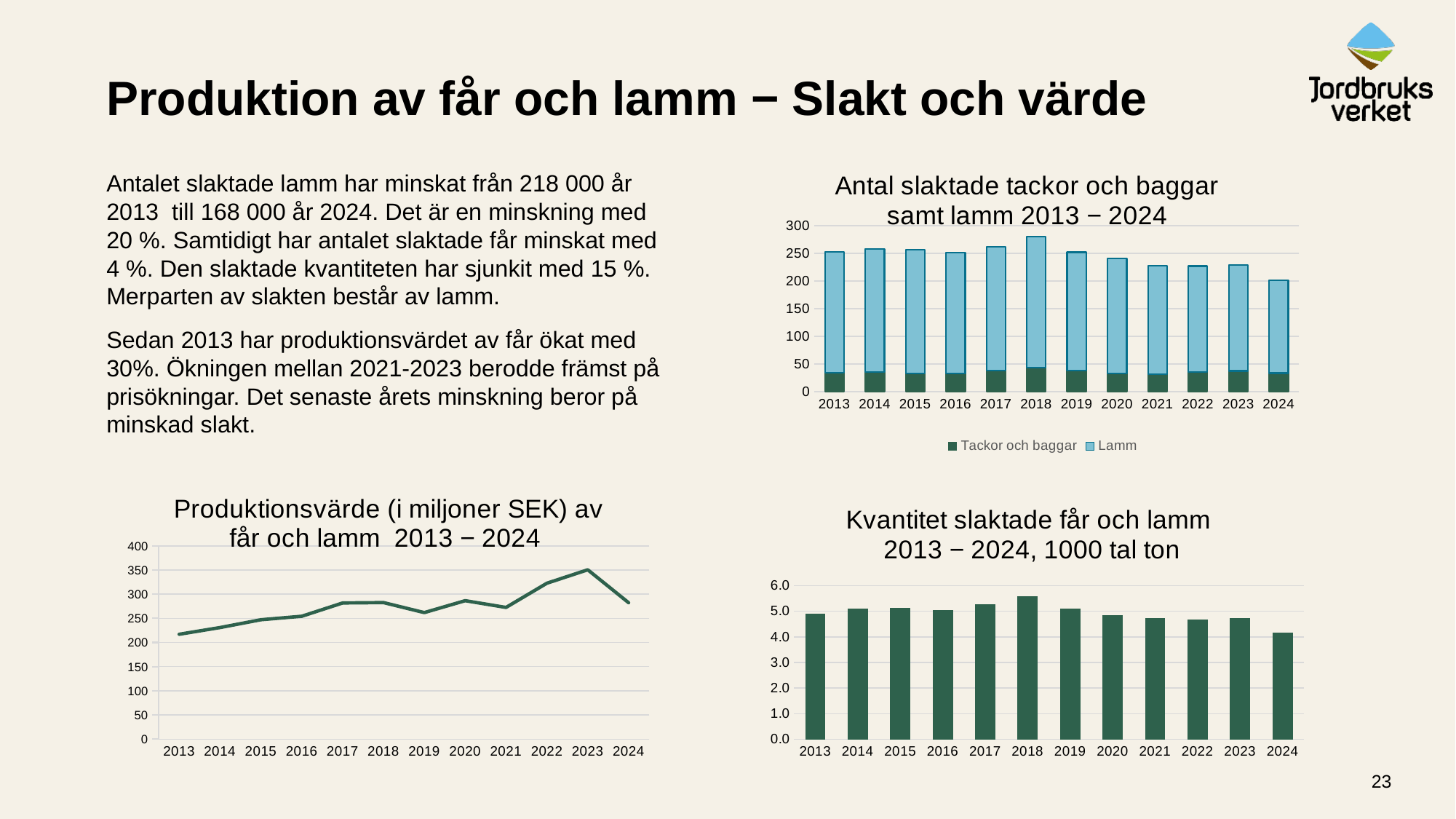
What kind of chart is "Produktionsvärde (i miljoner SEK) av får och lamm 2013 − 2024"? line chart In the chart "Produktionsvärde (i miljoner SEK) av får och lamm 2013 − 2024", which year has the lowest value? 2013 In the chart "Kvantitet slaktade får och lamm 2013 − 2024, 1000 tal ton", is the value for 2024 greater or less than 5.0? less How many years are shown on the x axis of the chart "Kvantitet slaktade får och lamm 2013 − 2024, 1000 tal ton"? 12 In the chart "Antal slaktade tackor och baggar samt lamm 2013 − 2024", is the total for 2024 greater or less than 250? less In the chart "Produktionsvärde (i miljoner SEK) av får och lamm 2013 − 2024", is the value for 2023 greater or less than 300? greater In the chart "Antal slaktade tackor och baggar samt lamm 2013 − 2024", which year has the lowest total bar? 2024 In the chart "Antal slaktade tackor och baggar samt lamm 2013 − 2024", how many series does the legend list? 2 What kind of chart is "Kvantitet slaktade får och lamm 2013 − 2024, 1000 tal ton"? bar chart In the chart "Produktionsvärde (i miljoner SEK) av får och lamm 2013 − 2024", which year has the highest value? 2023 In the chart "Antal slaktade tackor och baggar samt lamm 2013 − 2024", which year has the highest total bar? 2018 In the chart "Kvantitet slaktade får och lamm 2013 − 2024, 1000 tal ton", which year has the highest bar? 2018